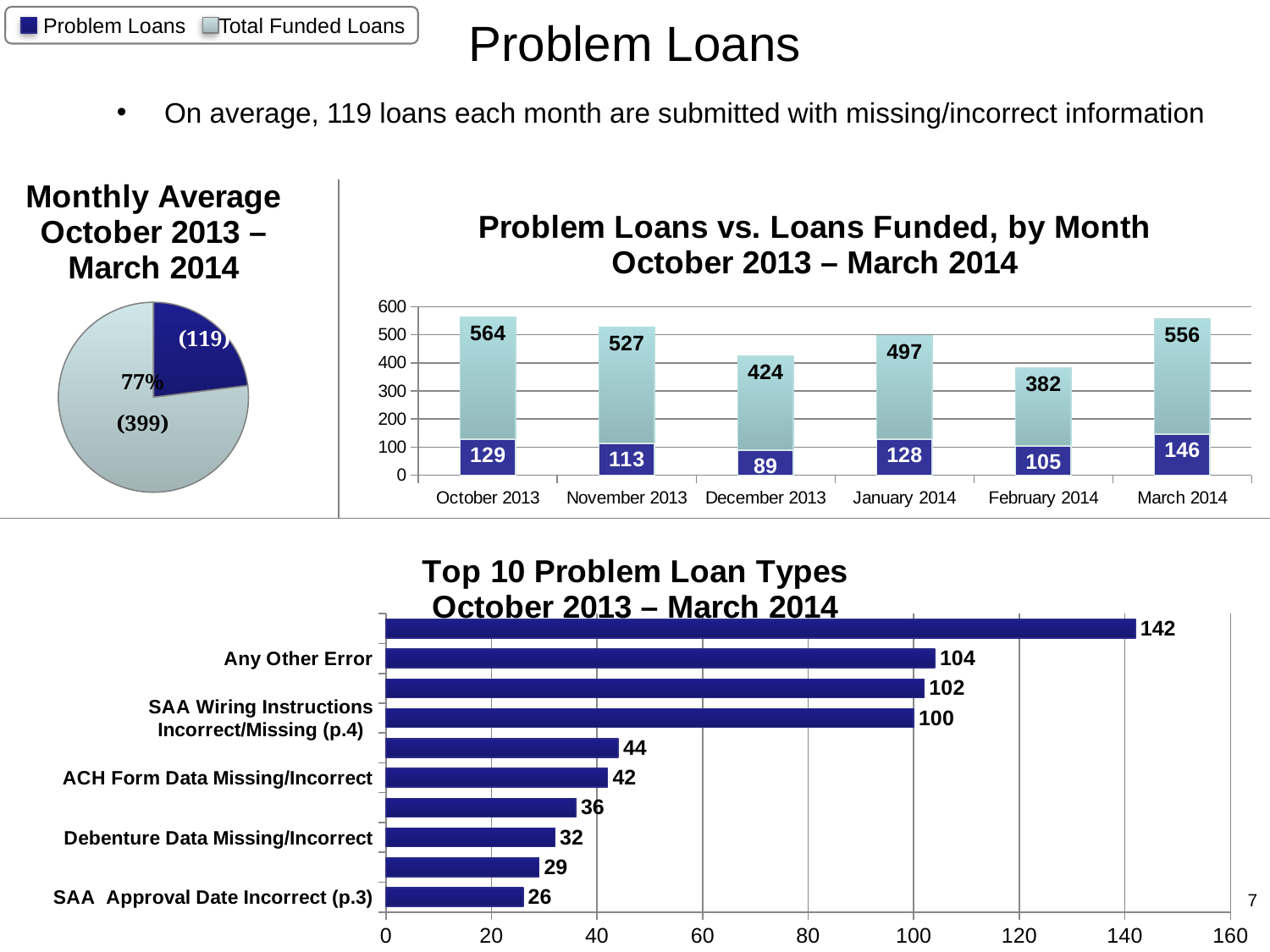
In the 'Top 10 Problem Loan Types' chart, which is larger: 'ACH Form Data Missing/Incorrect' or 'Debenture Data Missing/Incorrect'? ACH Form Data Missing/Incorrect In the 'Monthly Average October 2013 – March 2014' pie chart, what percentage is shown for the larger slice? 77% In the 'Problem Loans vs. Loans Funded, by Month' chart, which month has the highest Problem Loans value? March 2014 In the 'Top 10 Problem Loan Types' chart, what is the value for 'Any Other Error'? 104 In the 'Problem Loans vs. Loans Funded, by Month' chart, which month has the lowest Total Funded Loans value? February 2014 In the 'Problem Loans vs. Loans Funded, by Month' chart, how many months are shown on the x axis? 6 In the 'Top 10 Problem Loan Types' chart, what is the value for 'SAA Approval Date Incorrect (p.3)'? 26 How many series does the legend at the top left of the slide list? 2 In the 'Problem Loans vs. Loans Funded, by Month' chart, what is the difference between the Total Funded Loans values for October 2013 and November 2013? 37 In the 'Problem Loans vs. Loans Funded, by Month' chart, what is the Total Funded Loans value for February 2014? 382 What kind of chart is the 'Top 10 Problem Loan Types' chart? Bar chart In the 'Problem Loans vs. Loans Funded, by Month' chart, what is the Problem Loans value for December 2013? 89